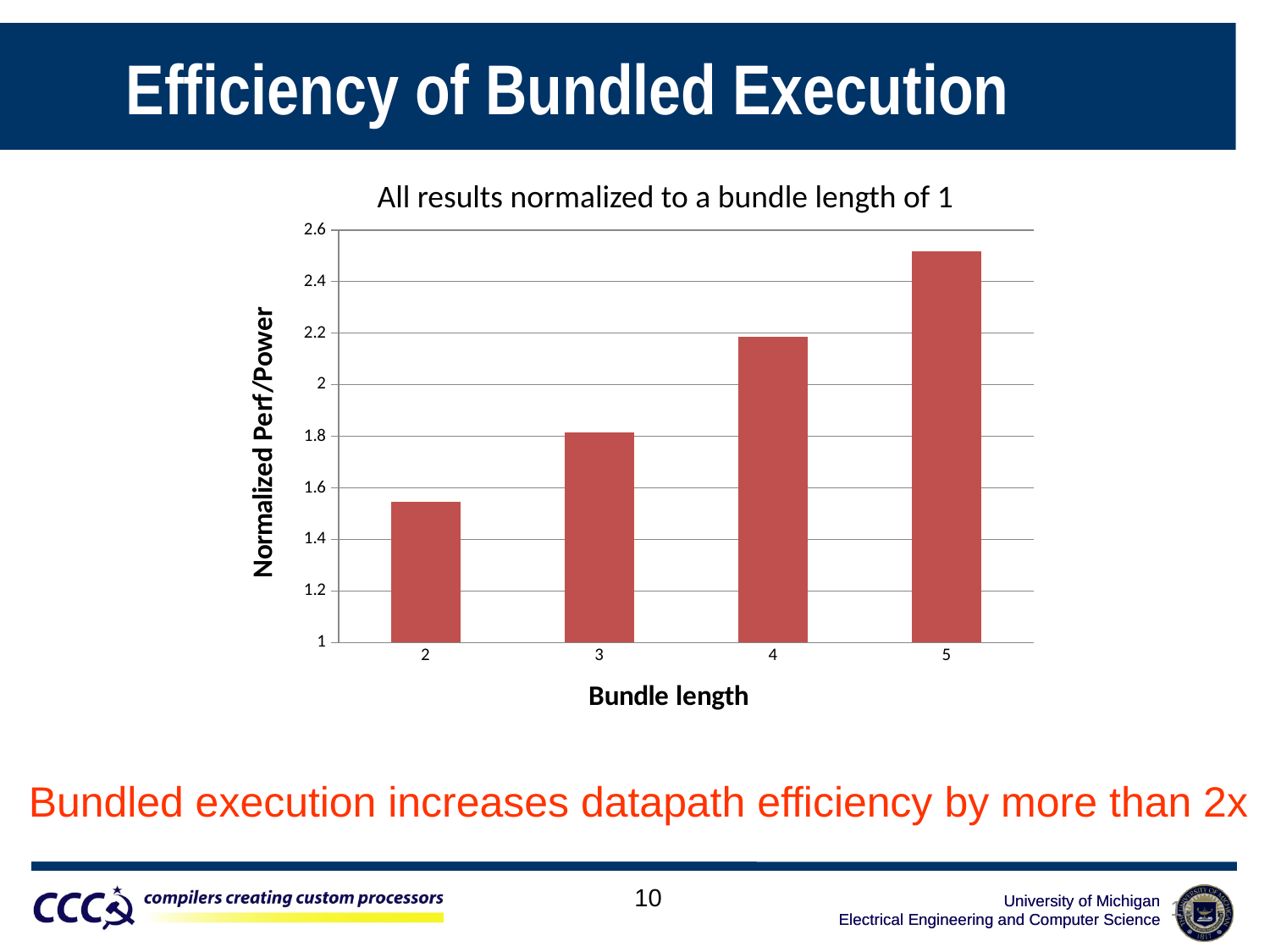
Which bundle length has the highest normalized Perf/Power? 5 Is the normalized Perf/Power for bundle length 5 greater or less than 2.4? greater Which has a larger normalized Perf/Power, bundle length 3 or bundle length 4? bundle length 4 Do the normalized Perf/Power values rise or fall as bundle length increases from 2 to 5? rise What is the title shown above the chart? All results normalized to a bundle length of 1 Is the normalized Perf/Power for bundle length 4 greater or less than 2? greater How many bundle lengths are plotted in the chart? 4 What kind of chart is shown on the slide? bar chart Is the normalized Perf/Power for bundle length 2 greater or less than 1.4? greater Which bundle length has the lowest normalized Perf/Power? 2 What is the label of the chart's vertical axis? Normalized Perf/Power